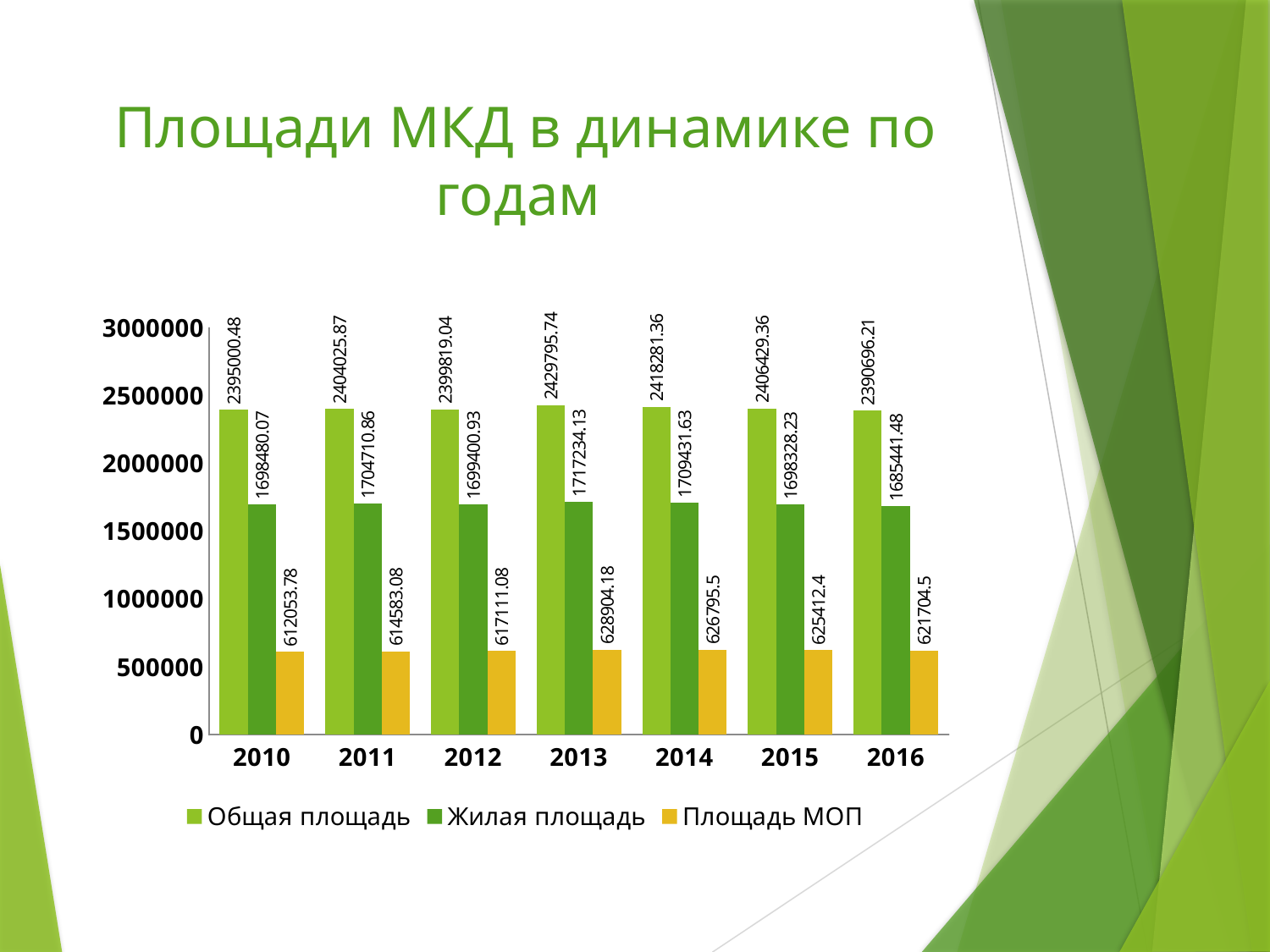
In which year is Площадь МОП the lowest? 2010 Which is larger: Жилая площадь in 2011 or Жилая площадь in 2015? 2011 In which year is Общая площадь the highest? 2013 What type of chart is shown on the slide? Bar chart How many series does the legend list? 3 What is the value of Жилая площадь in 2016? 1685441.48 What is the title of the chart? Площади МКД в динамике по годам What is the difference between Общая площадь and Жилая площадь in 2013? 712561.61 What is the value of Общая площадь in 2013? 2429795.74 What is the value of Площадь МОП in 2010? 612053.78 How many years are shown on the x axis? 7 Is the value for Жилая площадь in 2010 greater or less than 1500000? greater